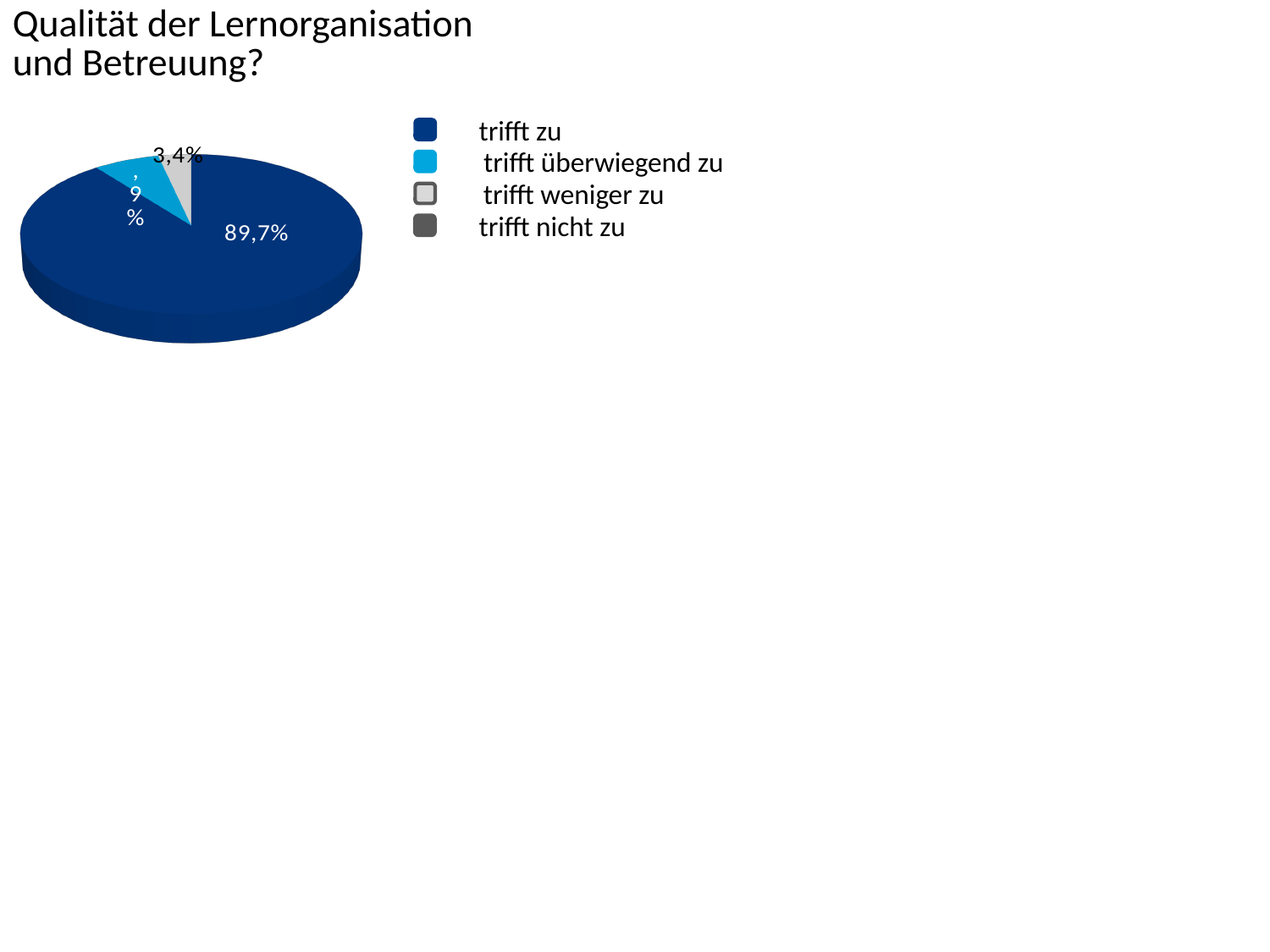
What is the difference in percentage points between "trifft zu" and "trifft weniger zu"? 86,3% What percentage is shown for "trifft zu"? 89,7% What is the title of the slide? Qualität der Lernorganisation und Betreuung? Which is larger, the slice for "trifft überwiegend zu" or the slice for "trifft weniger zu"? trifft überwiegend zu How many entries does the legend list? 4 What kind of chart is shown on the slide? pie chart What percentage is shown for "trifft weniger zu"? 3,4% Which is larger, the slice for "trifft zu" or the slice for "trifft weniger zu"? trifft zu What share of the pie does "trifft zu" take? 89,7% What colour represents "trifft zu" in the legend? dark blue Which category has the largest slice of the pie? trifft zu